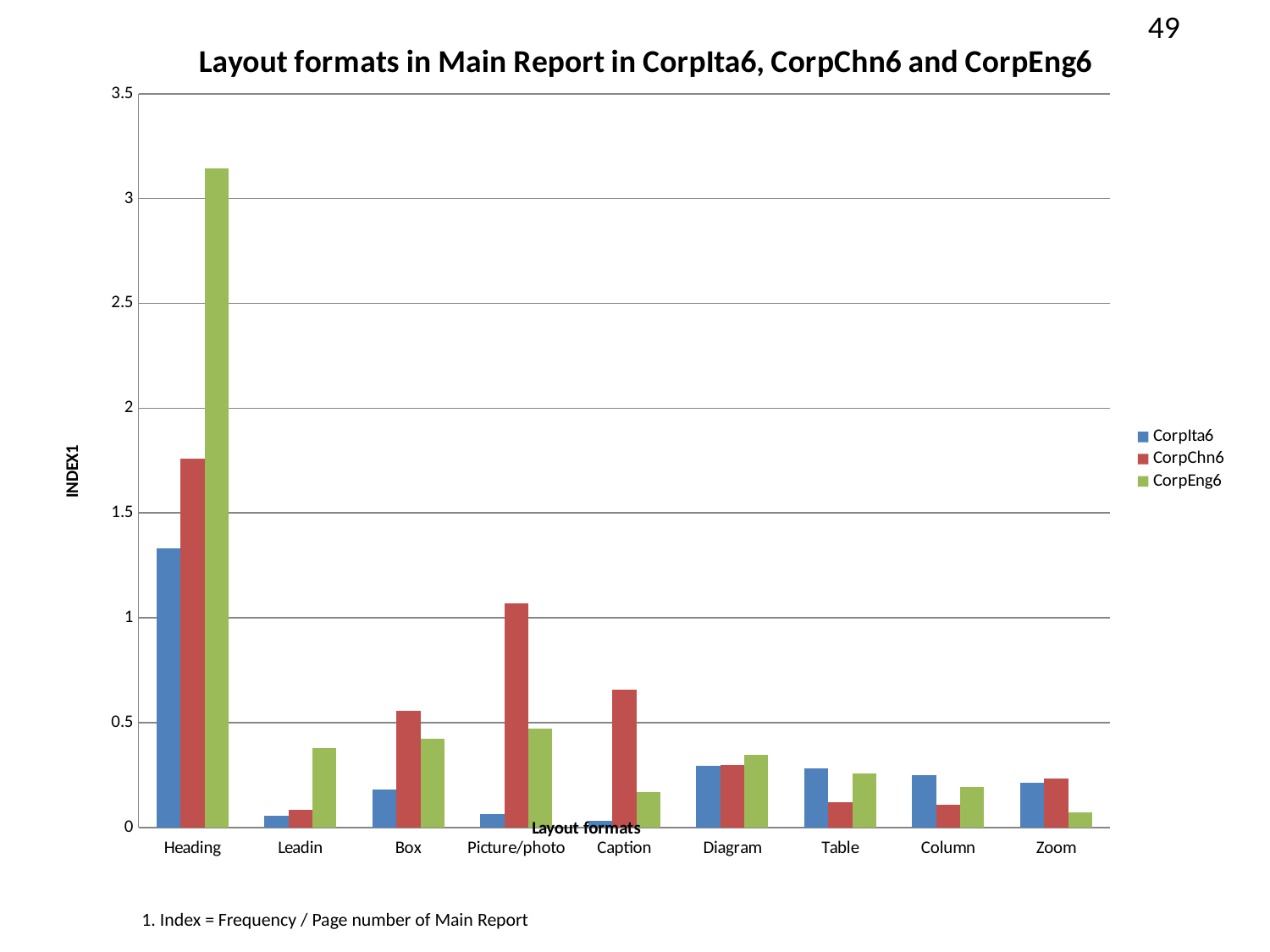
What kind of chart is shown on the slide? bar chart For Caption, which series has the larger value, CorpChn6 or CorpEng6? CorpChn6 What is the title of the vertical axis? INDEX1 Is the CorpIta6 value for Heading greater or less than 1.5? less How many series does the legend list? 3 Which layout format has the highest CorpEng6 value? Heading For Heading, which series has the larger value, CorpIta6 or CorpChn6? CorpChn6 Which layout format has the lowest CorpEng6 value? Zoom Is the CorpEng6 value for Heading greater or less than 3? greater How many layout format categories are shown on the x axis? 9 For Box, which series has the larger value, CorpChn6 or CorpEng6? CorpChn6 Is the CorpChn6 value for Picture/photo greater or less than 1? greater